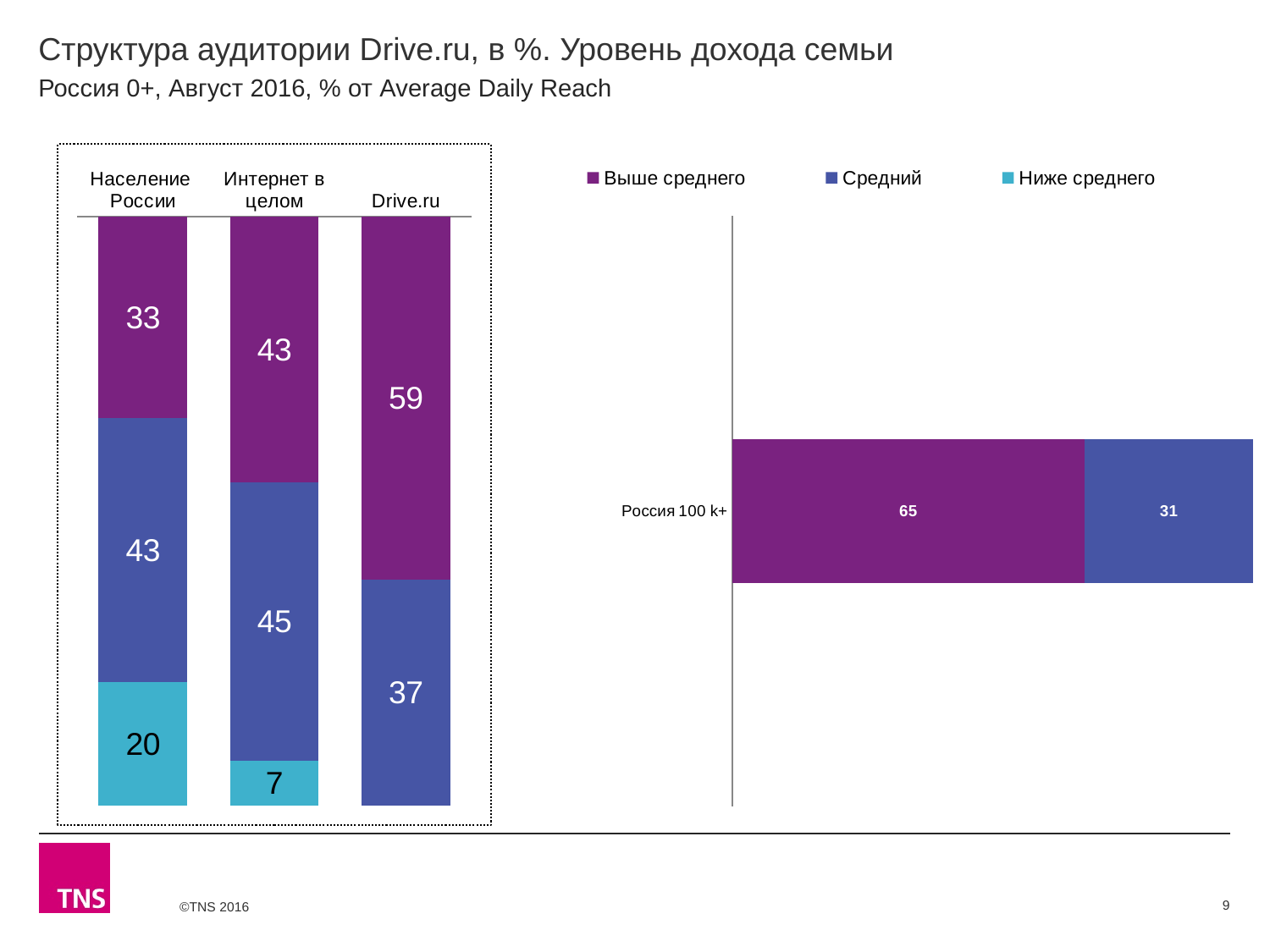
In the left chart, what is the value for 'Выше среднего' for Drive.ru? 59 In the left chart, which is larger: 'Средний' for Население России or 'Средний' for Drive.ru? Население России In the right chart, what is the value for 'Средний' for Россия 100 k+? 31 In the left chart, what is the difference between the 'Выше среднего' values for Drive.ru and Население России? 26 In the right chart, what is the value for 'Выше среднего' for Россия 100 k+? 65 In the left chart, what is the value for 'Средний' for Интернет в целом? 45 How many series does the legend list? 3 In the left chart, which category has the lowest value for 'Ниже среднего' among those with a printed label? Интернет в целом In the left chart, what is the value for 'Ниже среднего' for Население России? 20 In the left chart, which category has the highest value for 'Выше среднего'? Drive.ru How many categories are shown in the left chart? 3 What type of chart is the right chart? Stacked bar chart